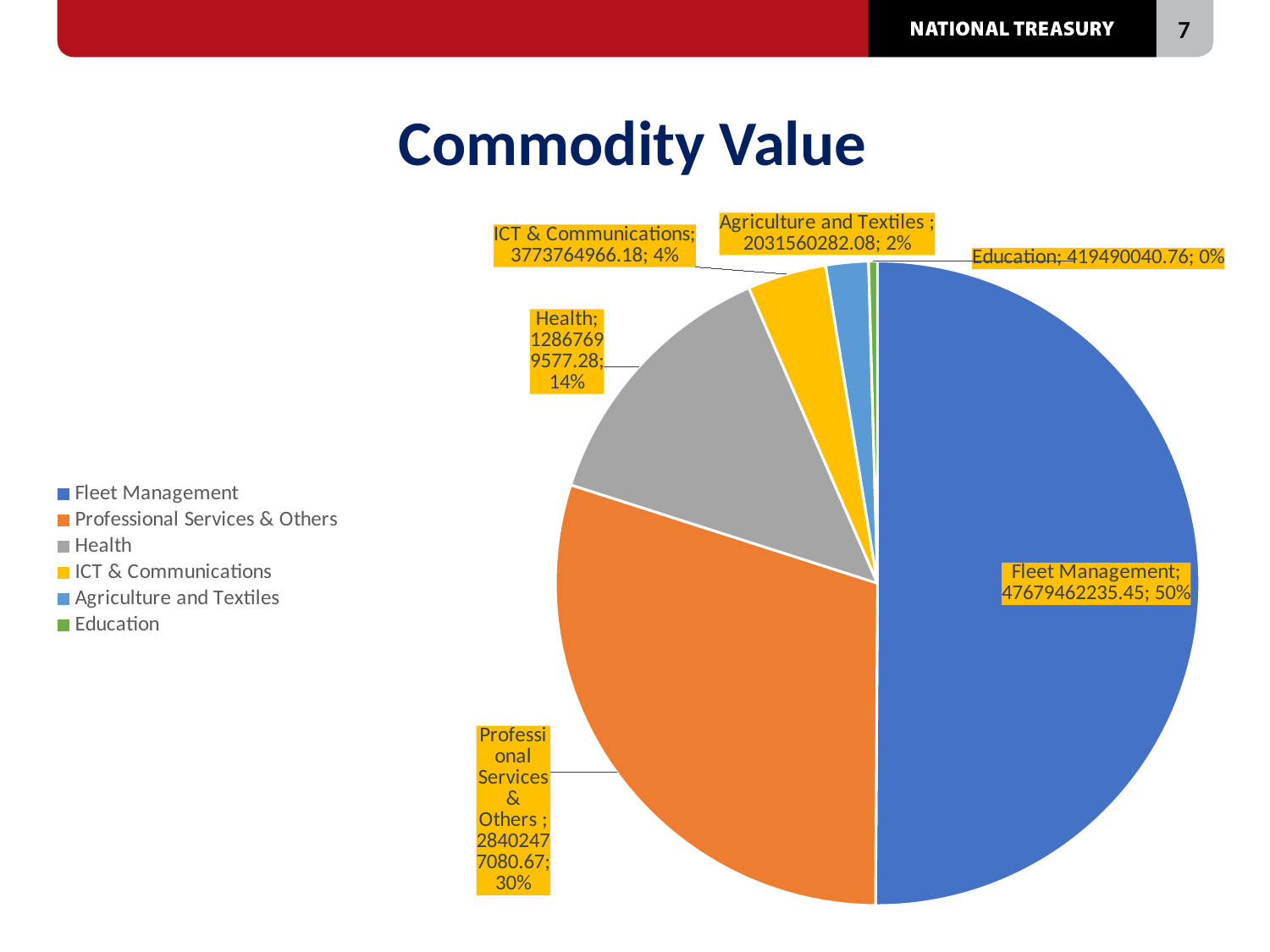
What share of the pie does Health represent? 14% Which is larger, the value for Health or the value for ICT & Communications? Health What is the value for Education? 419490040.76 What is the value for ICT & Communications? 3773764966.18 What type of chart is shown on the slide? pie chart Which category has the largest slice of the pie? Fleet Management What is the value for Agriculture and Textiles? 2031560282.08 What share of the pie does Professional Services & Others represent? 30% Which category has the smallest slice of the pie? Education What is the title of the chart? Commodity Value What is the value for Fleet Management? 47679462235.45 How many categories does the legend list? 6